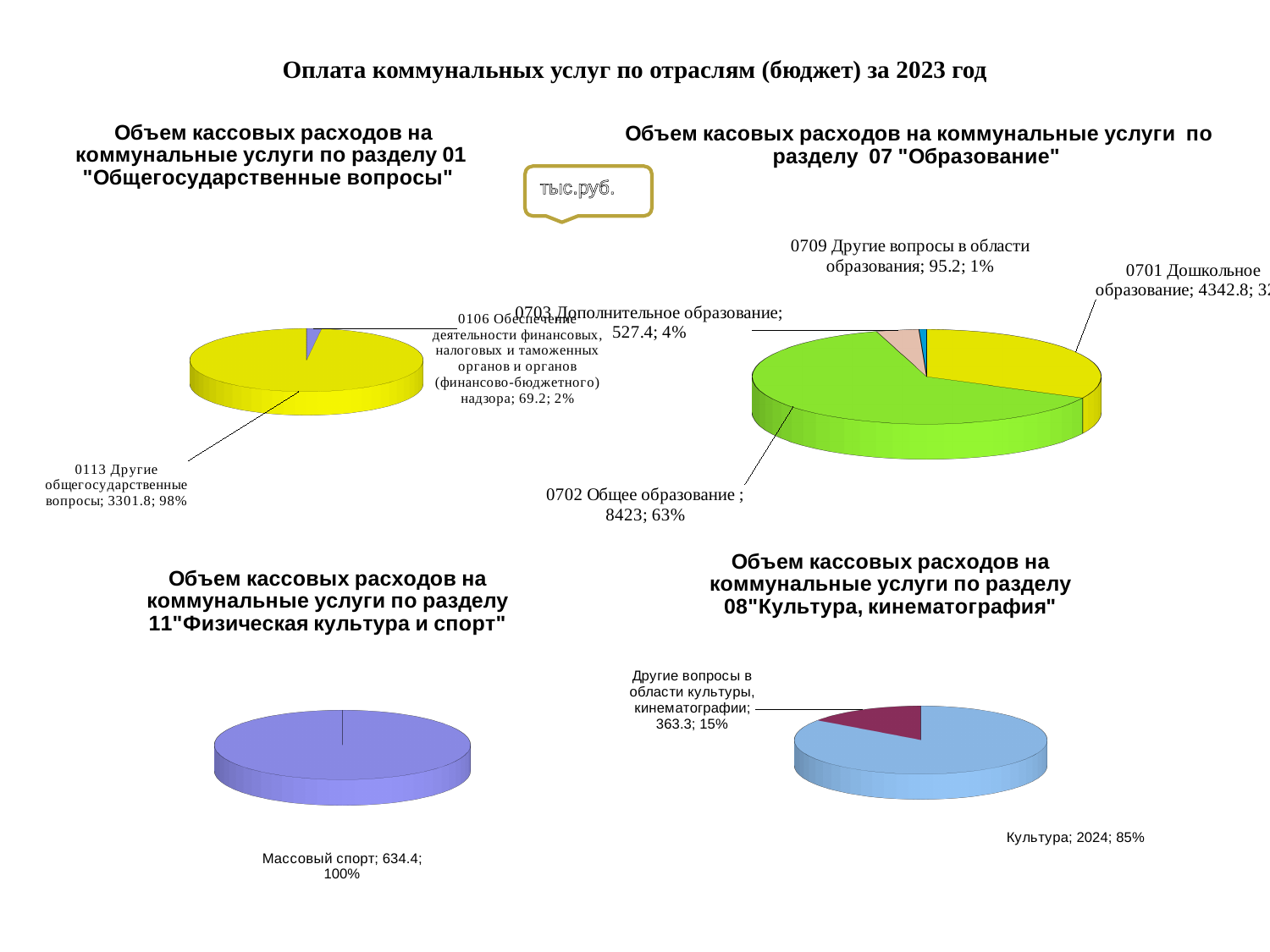
In the chart for section 07 "Образование", how many slices does the pie have? 4 In the chart for section 07 "Образование", what is the value for 0702 Общее образование? 8423 In the chart for section 07 "Образование", which category has the smallest value? 0709 Другие вопросы в области образования What type of chart is used for section 08 "Культура, кинематография"? Pie chart In the chart for section 11 "Физическая культура и спорт", what is the value for Массовый спорт? 634.4 In the chart for section 07 "Образование", what is the difference between the values for 0703 Дополнительное образование and 0709 Другие вопросы в области образования? 432.2 In the chart for section 08 "Культура, кинематография", what is the value for Культура? 2024 In the chart for section 01 "Общегосударственные вопросы", what is the value for 0113 Другие общегосударственные вопросы? 3301.8 In the chart for section 08 "Культура, кинематография", which is larger: Культура or Другие вопросы в области культуры, кинематографии? Культура In the chart for section 01 "Общегосударственные вопросы", what share of the pie does the 0106 slice represent? 2% In the chart for section 07 "Образование", what share of the pie does 0703 Дополнительное образование represent? 4% In the chart for section 07 "Образование", which category has the largest value? 0702 Общее образование